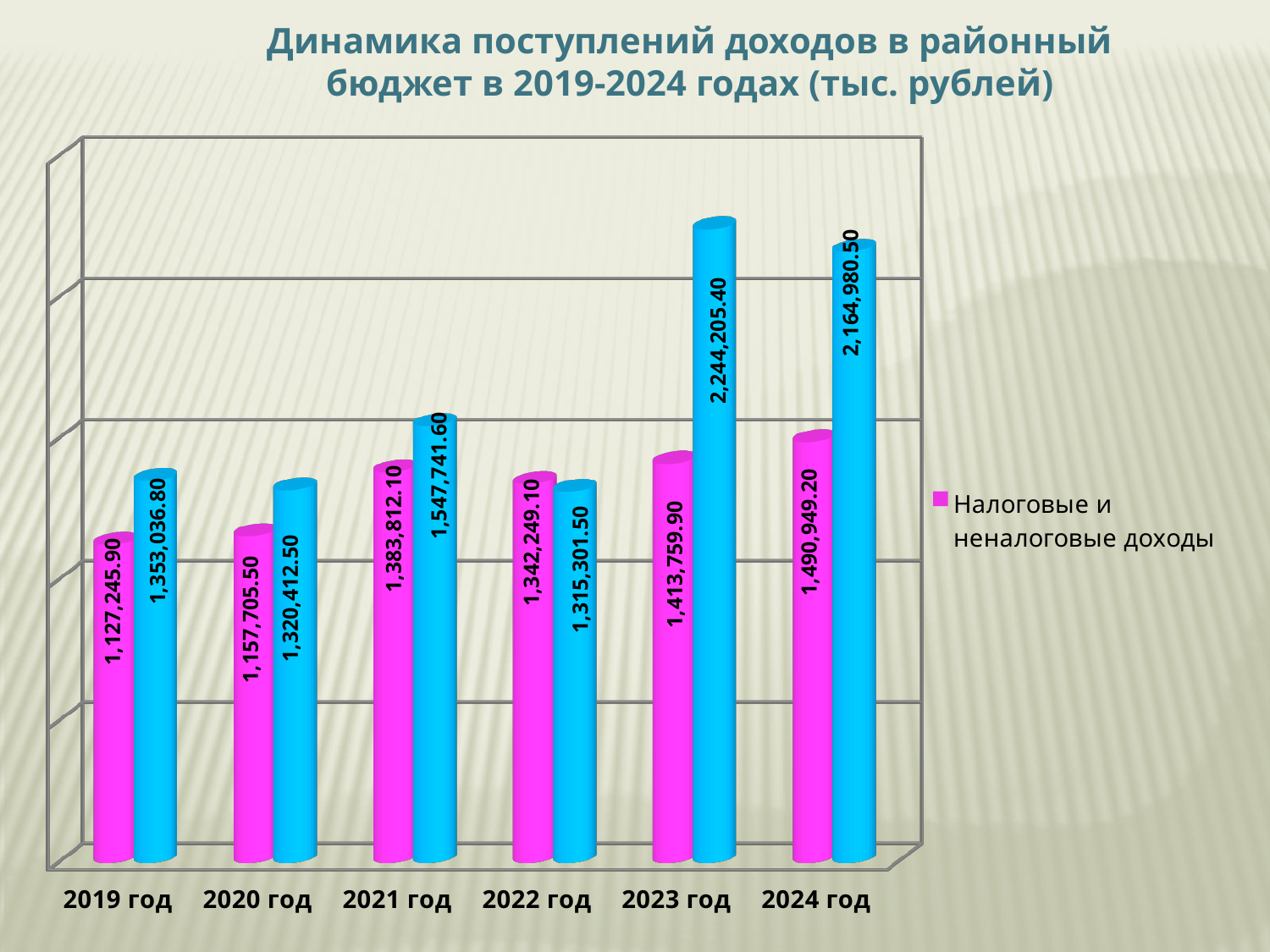
What is the title of the chart? Динамика поступлений доходов в районный бюджет в 2019-2024 годах (тыс. рублей) What is the difference between the blue bar and the Налоговые и неналоговые доходы bar for 2024 год? 674,031.30 What type of chart is shown on the slide? Bar chart What is the value shown on the blue bar for 2021 год? 1,547,741.60 In which year is Налоговые и неналоговые доходы the lowest? 2019 год How many years are shown on the x axis? 6 What is the value shown on the blue bar for 2023 год? 2,244,205.40 What is the value of Налоговые и неналоговые доходы for 2024 год? 1,490,949.20 In which year is the blue bar the lowest? 2022 год Which is larger for 2022 год: the Налоговые и неналоговые доходы bar or the blue bar? Налоговые и неналоговые доходы What is the value of Налоговые и неналоговые доходы for 2019 год? 1,127,245.90 In which year is the blue bar the highest? 2023 год